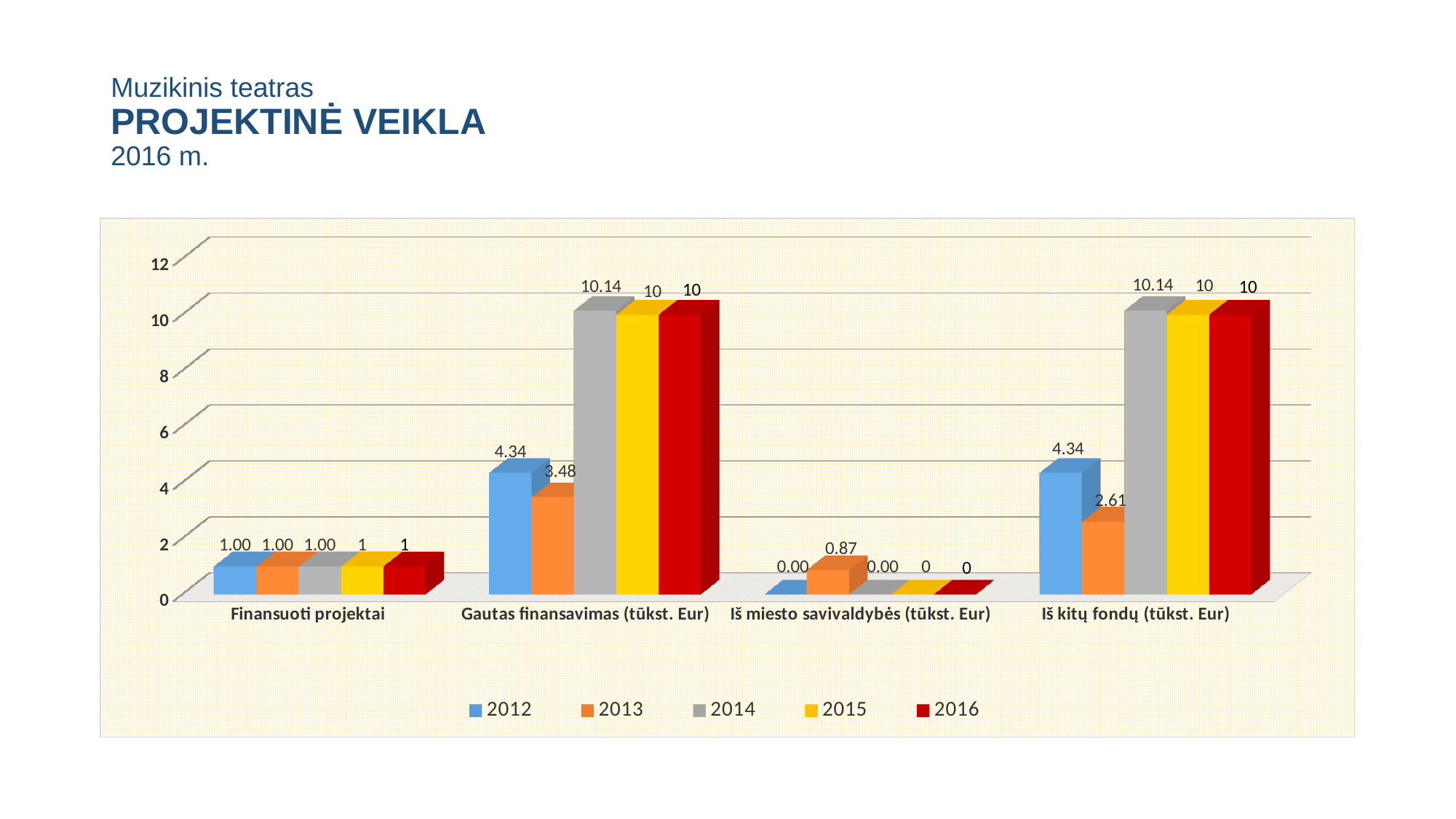
How many categories are shown on the x axis of the chart? 4 What is the value for 2013 in the 'Iš miesto savivaldybės (tūkst. Eur)' category? 0.87 What is the value for 2012 in the 'Gautas finansavimas (tūkst. Eur)' category? 4.34 How many series does the legend list? 5 Which year has the highest value in the 'Gautas finansavimas (tūkst. Eur)' category? 2014 Which year has the lowest value in the 'Iš kitų fondų (tūkst. Eur)' category? 2013 What is the value for 2013 in the 'Iš kitų fondų (tūkst. Eur)' category? 2.61 Which colour represents the 2016 series in the chart? Red In the 'Iš kitų fondų (tūkst. Eur)' category, which is larger: the value for 2012 or the value for 2013? 2012 What is the difference between the 2012 and 2013 values in the 'Gautas finansavimas (tūkst. Eur)' category? 0.86 What is the value for 2014 in the 'Gautas finansavimas (tūkst. Eur)' category? 10.14 What kind of chart is shown on the slide? Bar chart